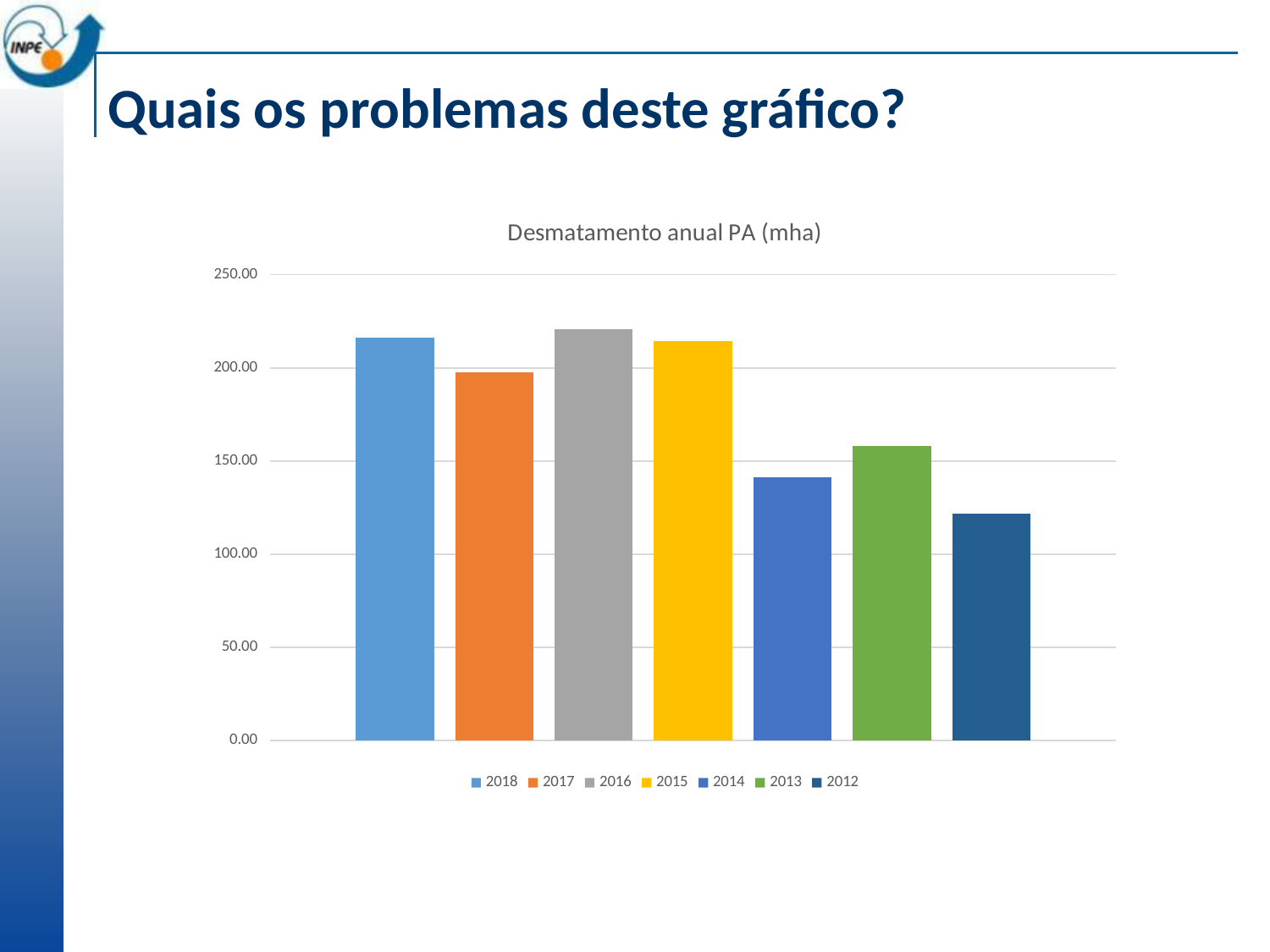
How many entries does the chart legend list? 7 Which year has the lowest bar in the chart? 2012 Is the value for 2018 greater or less than 200.00? greater What kind of chart is shown on the slide? bar chart Which is larger, the value for 2013 or the value for 2014? 2013 Is the value for 2014 greater or less than 150.00? less Which year has the highest bar in the chart? 2016 Is the value for 2012 greater or less than 100.00? greater Which colour is used for the 2015 bar? yellow How many bars are plotted in the chart? 7 What is the title of the chart? Desmatamento anual PA (mha)